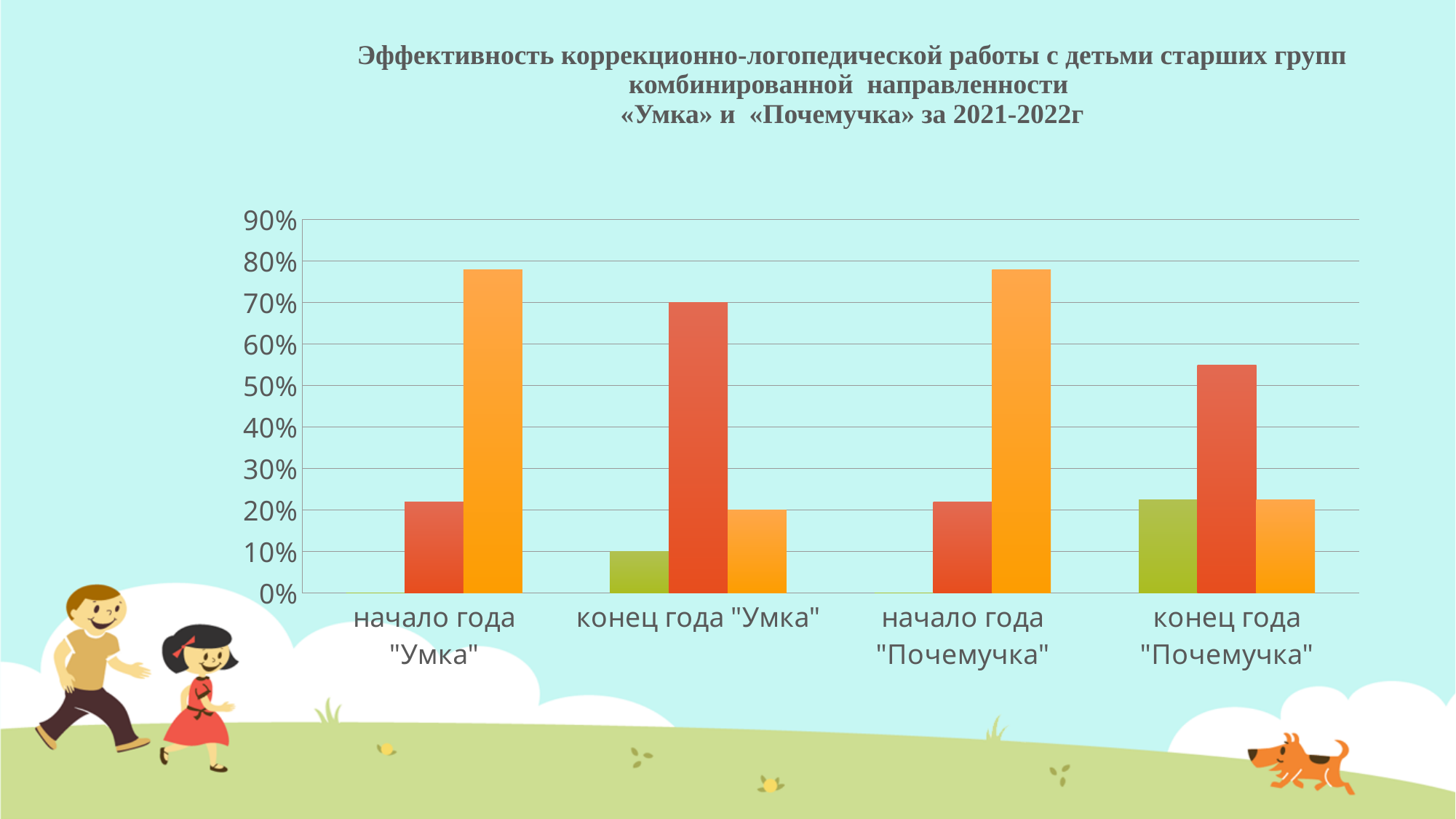
Which is larger: the red bar for конец года "Умка" or the red bar for конец года "Почемучка"? конец года "Умка" What kind of chart is shown on the slide? bar chart What is the value of the orange bar for конец года "Умка"? 20% What is the difference between the red bar and the orange bar for конец года "Умка"? 50% Which coloured bar is the tallest in the конец года "Умка" category? red What is the value of the green bar for конец года "Умка"? 10% How many categories are shown on the x axis of the chart? 4 What is the value of the red bar for конец года "Умка"? 70% Is the value of the red bar for конец года "Почемучка" greater or less than 50%? greater What is the highest value shown on the vertical axis of the chart? 90% Is the value of the orange bar for начало года "Умка" greater or less than 70%? greater Which coloured bar is the shortest in the конец года "Умка" category? green